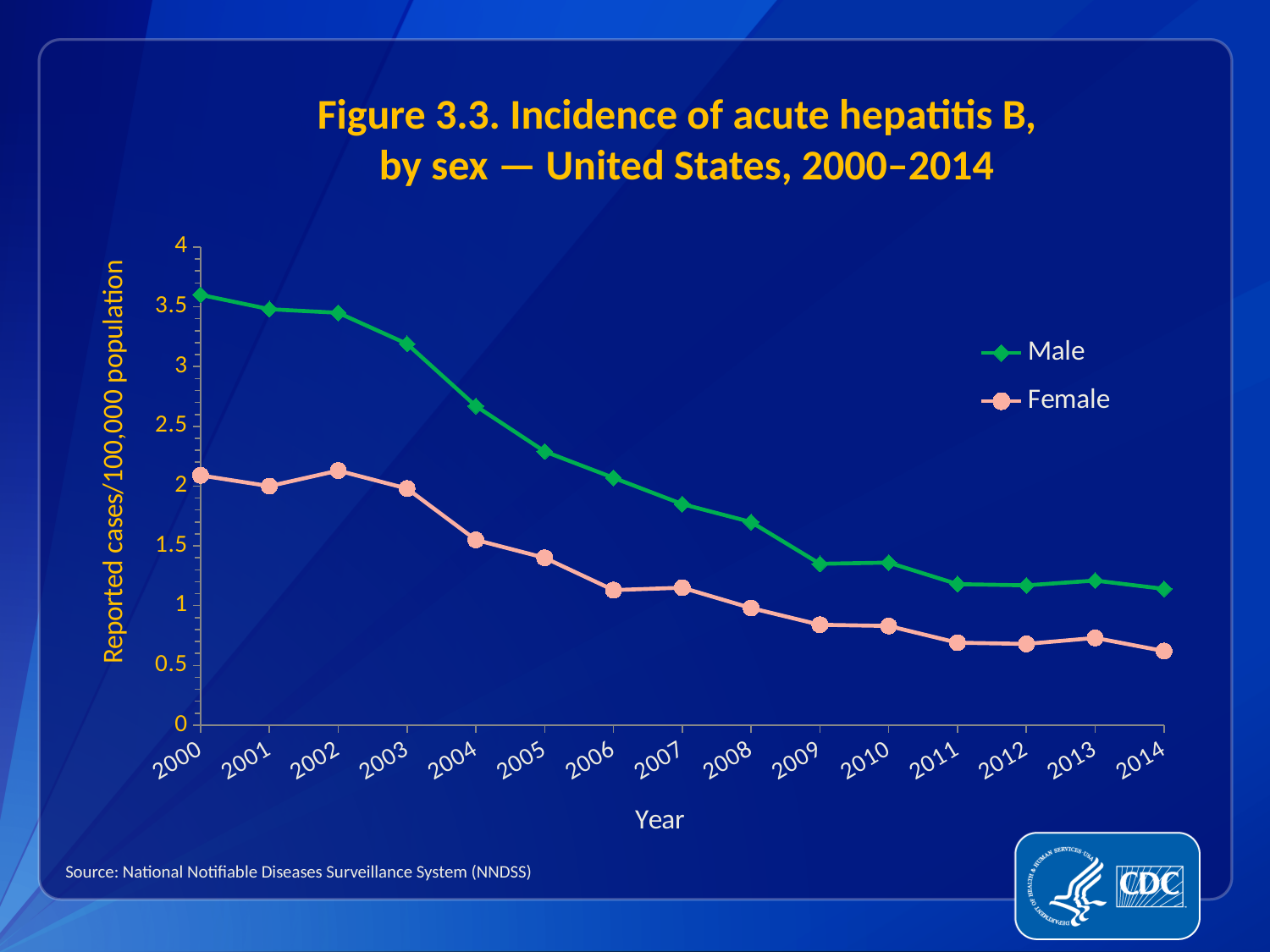
Is the Male value for 2009 greater or less than 1.5? less How many series does the legend list? 2 What kind of chart is shown on the slide? line chart In 2005, which series has the higher value, Male or Female? Male In which year is the Male incidence rate highest? 2000 Is the Female value for 2004 greater or less than 2? less Is the Male value for 2004 greater or less than 3? less How many years are plotted along the x axis? 15 Does the Male incidence rate rise or fall from 2000 to 2014? fall What is the label on the y axis? Reported cases/100,000 population